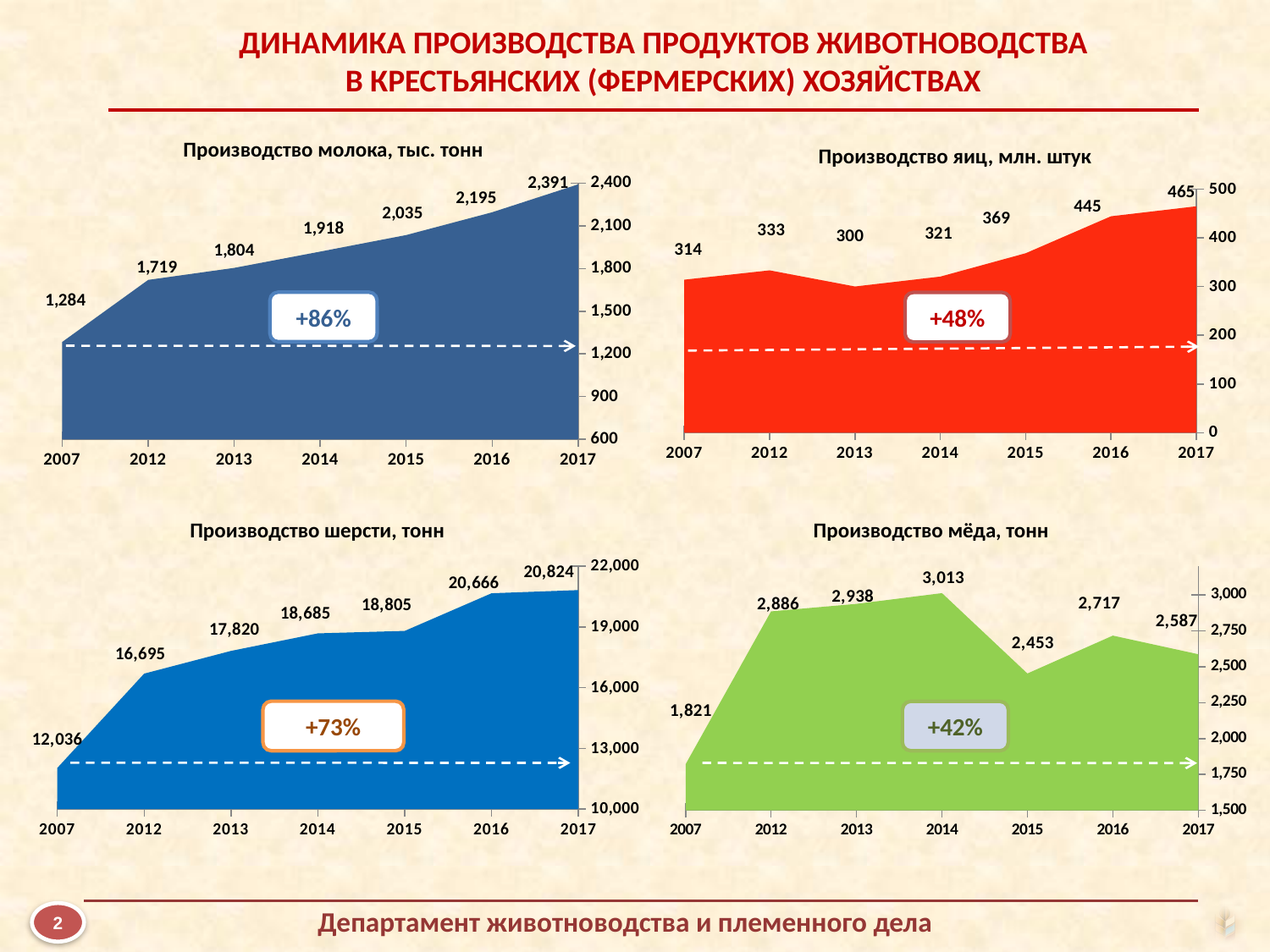
In the chart titled 'Производство шерсти, тонн', what is the value for 2012? 16,695 In the chart titled 'Производство яиц, млн. штук', what is the value for 2013? 300 What type of chart is 'Производство яиц, млн. штук'? Area chart In the chart titled 'Производство молока, тыс. тонн', do the values rise or fall from 2007 to 2017? Rise In the chart titled 'Производство молока, тыс. тонн', what is the value for 2017? 2,391 In the chart titled 'Производство мёда, тонн', which is larger, the value for 2015 or the value for 2016? 2016 In the chart titled 'Производство шерсти, тонн', how many years are plotted? 7 In the chart titled 'Производство мёда, тонн', what is the difference between the 2014 value and the 2015 value? 560 In the chart titled 'Производство молока, тыс. тонн', what is the difference between the 2017 value and the 2007 value? 1,107 In the chart titled 'Производство яиц, млн. штук', which year has the lowest value? 2013 What percentage change is shown in the label on the chart titled 'Производство шерсти, тонн'? +73% In the chart titled 'Производство мёда, тонн', which year has the highest value? 2014